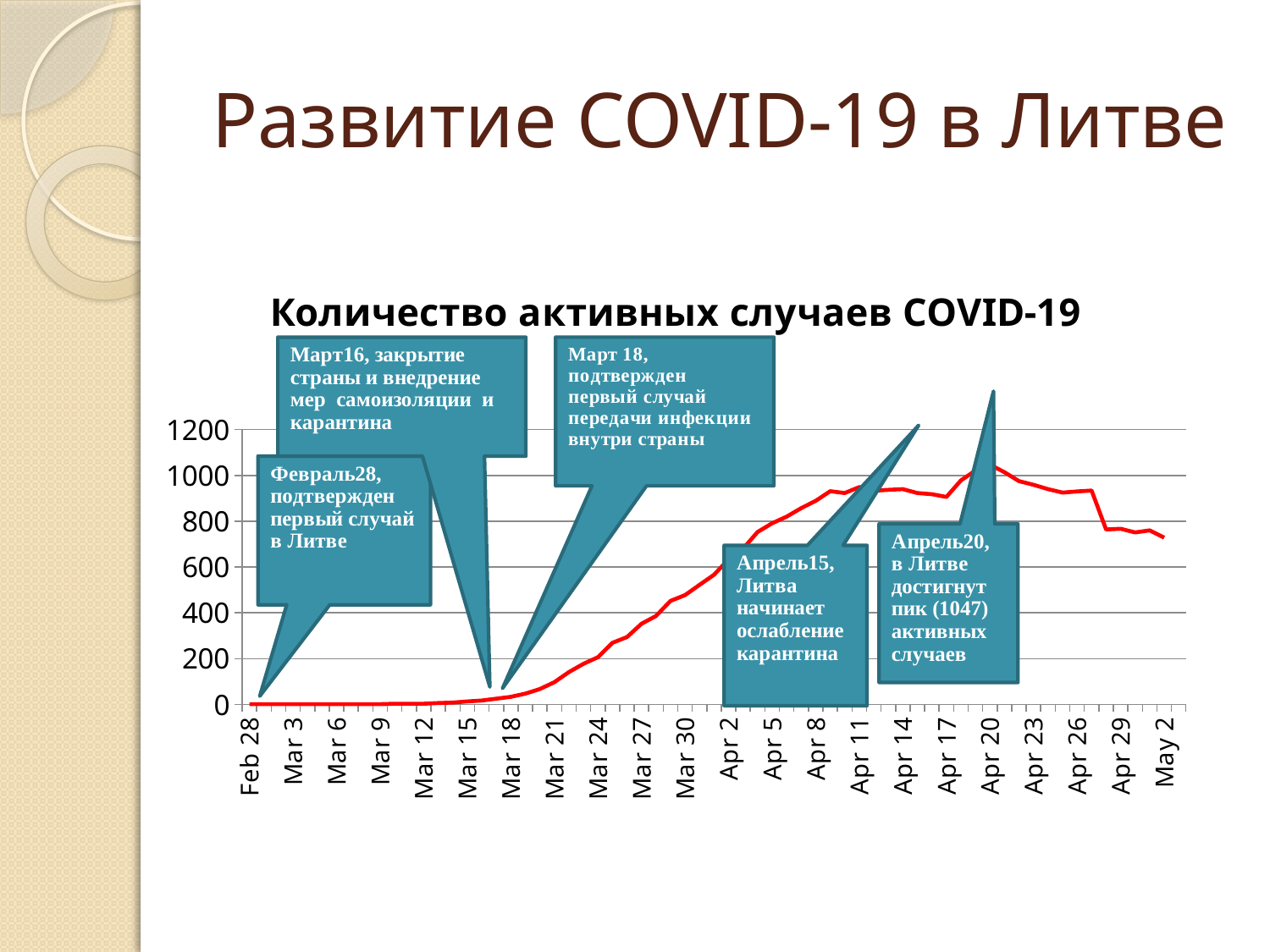
What is the title of the chart? Количество активных случаев COVID-19 Is the value for Mar 12 greater or less than 200? less Which date has the larger value, Mar 24 or Apr 8? Apr 8 Is the value for Apr 8 greater or less than 800? greater On which date does the number of active cases reach its highest value? Apr 20 What is the peak number of active COVID-19 cases reached in Lithuania, according to the chart annotation? 1047 According to the annotation, what happened on March 16? закрытие страны и внедрение мер самоизоляции и карантина Is the value for Mar 24 greater or less than 400? less Do the values rise or fall between Feb 28 and Apr 20? rise Do the values rise or fall between Apr 20 and May 2? fall What kind of chart is shown on the slide? line chart